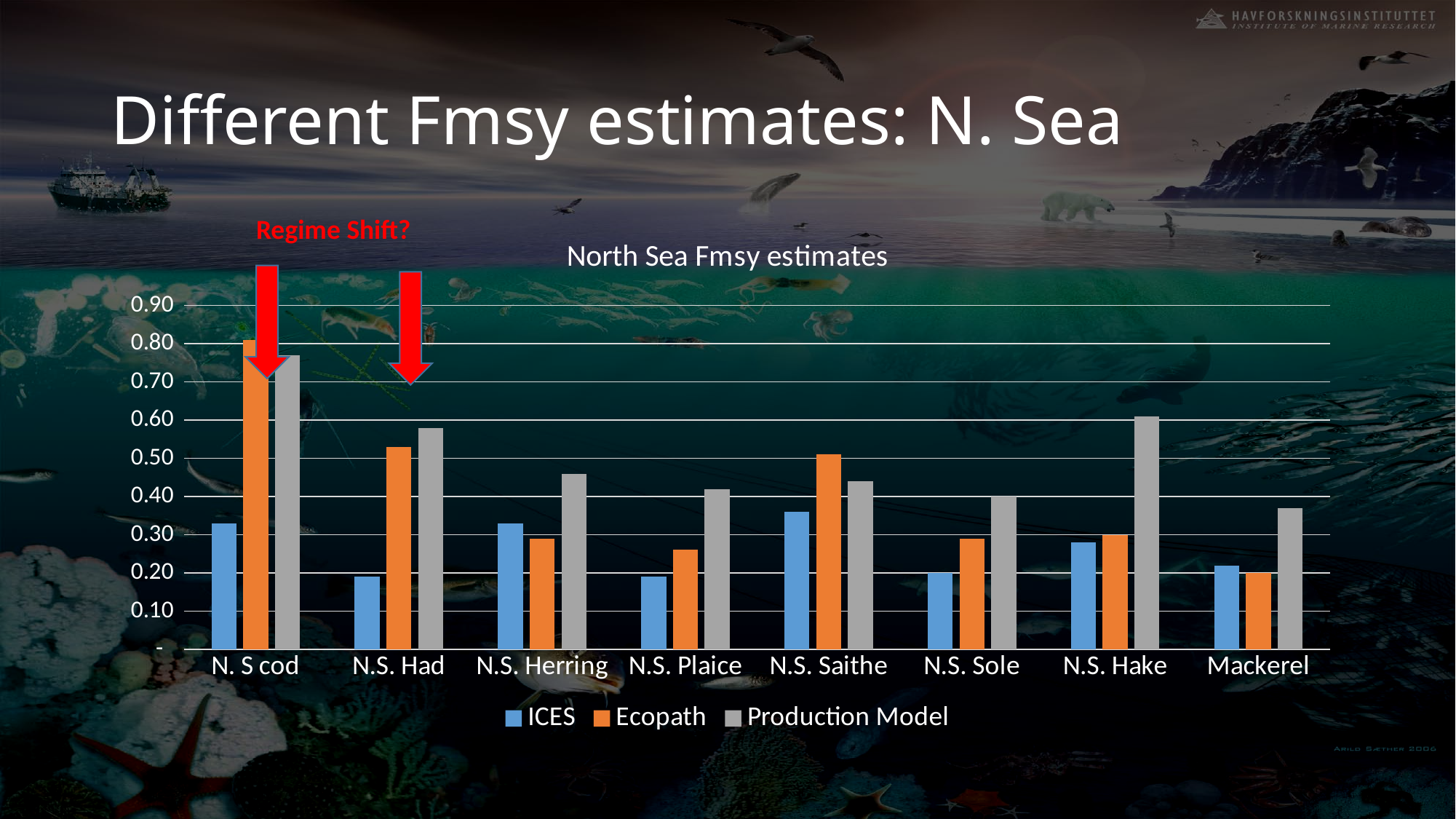
Which category has the lowest Ecopath value? Mackerel Is the Production Model value for N.S. Hake greater or less than 0.50? greater Is the Production Model value for Mackerel greater or less than 0.40? less What kind of chart is shown on the slide? Bar chart For N.S. Saithe, which is larger: the Ecopath value or the Production Model value? Ecopath How many fish stock categories are shown on the x axis? 8 Which series are listed in the legend? ICES, Ecopath, Production Model How many series does the chart legend list? 3 Is the Ecopath value for N. S cod greater or less than 0.70? greater For N.S. Had, which is larger: the ICES value or the Ecopath value? Ecopath Which category has the highest Ecopath value? N. S cod What is the title of the chart? North Sea Fmsy estimates